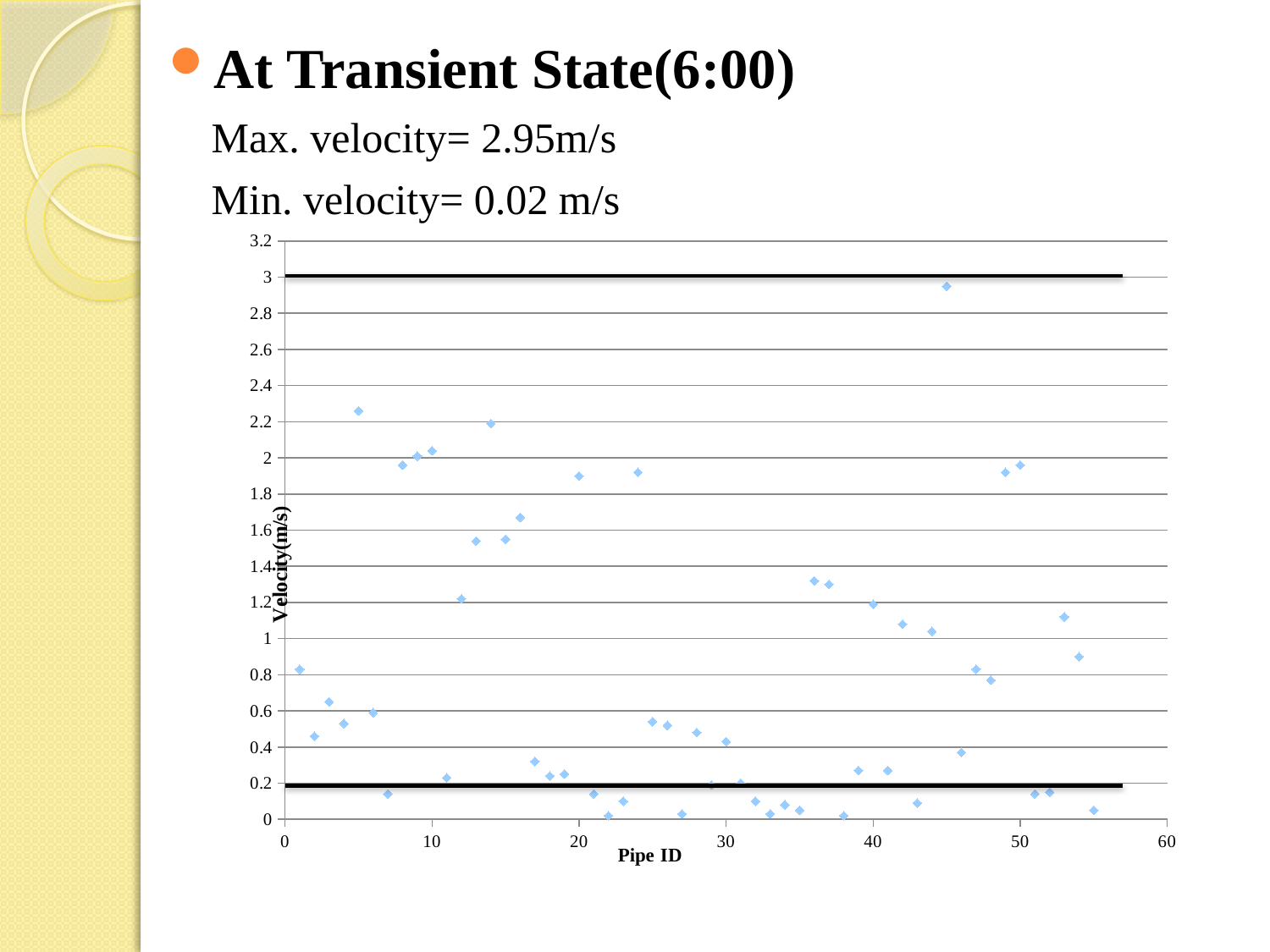
Which Pipe ID has the highest velocity in the chart? 45 Is the velocity for Pipe ID 22 greater or less than 0.2? less Is the velocity for Pipe ID 17 greater or less than 0.4? less What is the title of the vertical axis of the chart? Velocity(m/s) What kind of chart is shown on the slide? scatter chart Is the velocity for Pipe ID 36 greater or less than 1.2? greater What is the title of the horizontal axis of the chart? Pipe ID Which has the higher velocity, Pipe ID 20 or Pipe ID 36? Pipe ID 20 Which has the higher velocity, Pipe ID 45 or Pipe ID 5? Pipe ID 45